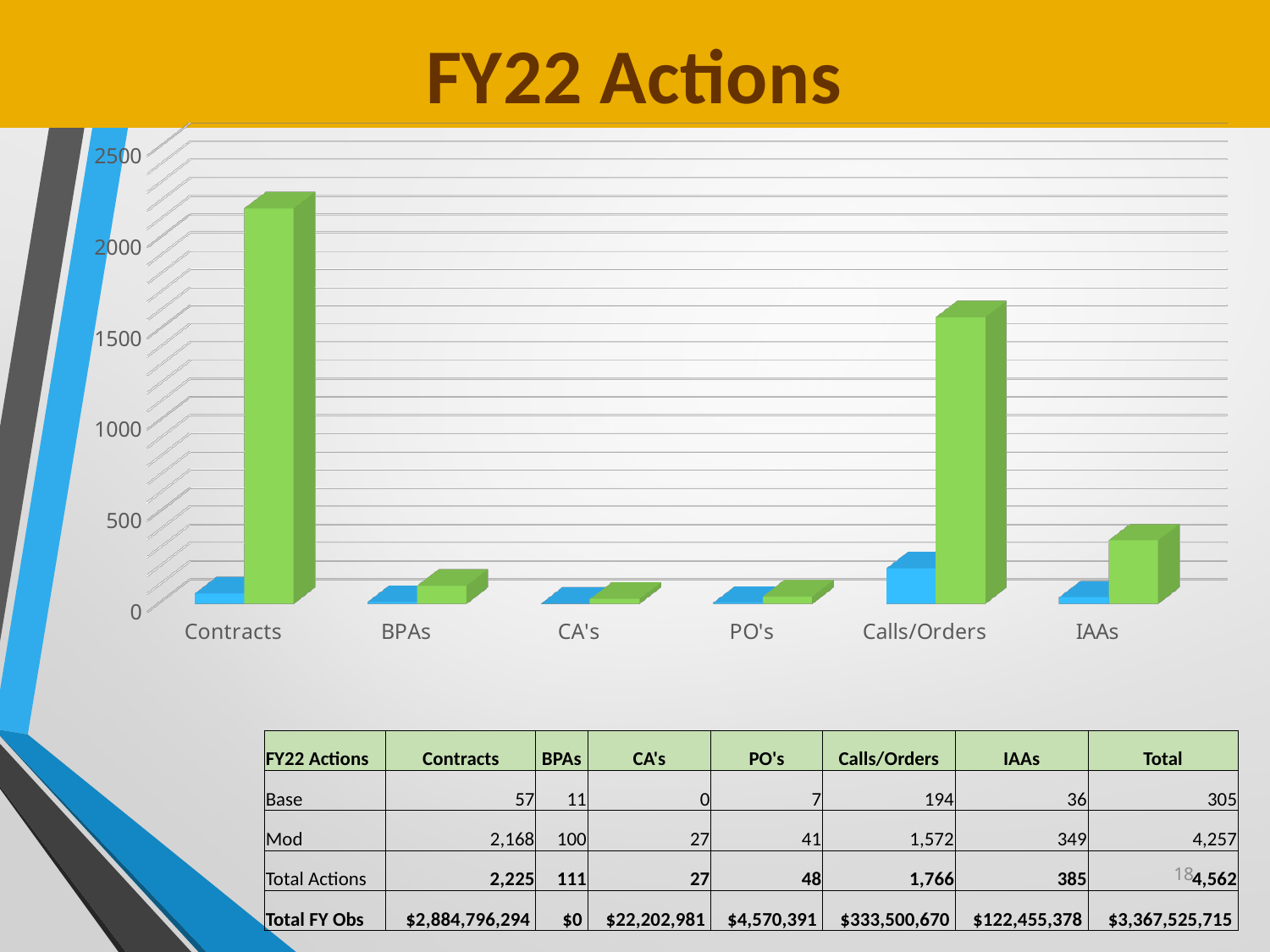
Is the green bar for Contracts greater or less than 2000? greater Is the green bar for IAAs greater or less than 500? less According to the table below the chart, what is the Total Actions value for Contracts? 2,225 Which has the taller green bar, Calls/Orders or BPAs? Calls/Orders What kind of chart is shown on the slide? bar chart Is the green bar for Calls/Orders greater or less than 1000? greater How many categories are shown along the x axis of the chart? 6 How many bars are plotted for each category in the chart? 2 What is the title of the chart? FY22 Actions According to the table below the chart, what is the difference between the Mod and Base values for Contracts? 2,111 According to the table below the chart, what is the Base value for Calls/Orders? 194 Which category has the tallest green bar in the chart? Contracts